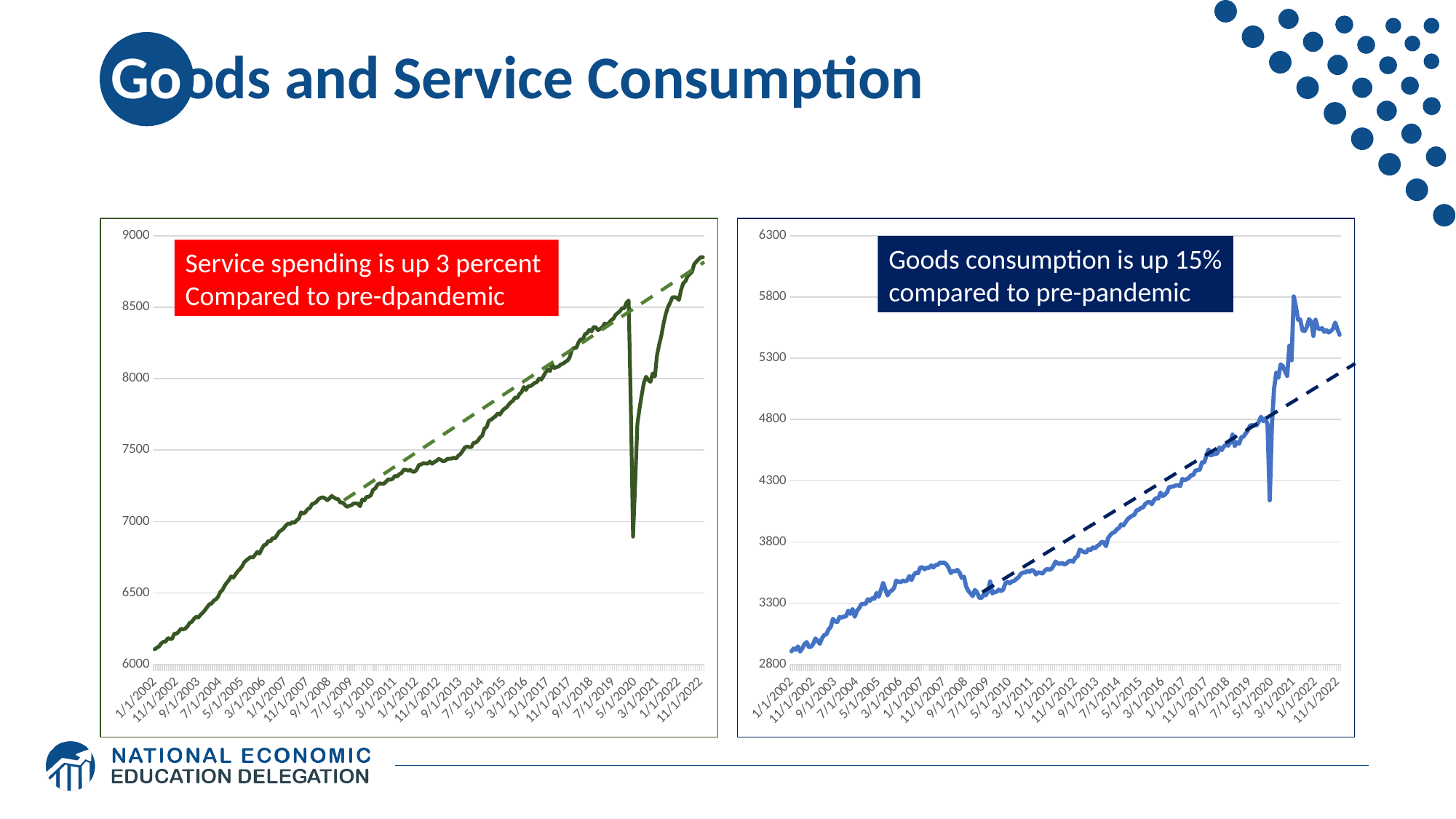
In the right chart (goods consumption), is the value at the end of the series (11/1/2022) greater or less than 5300? greater In the left chart (service spending), do the values generally rise or fall from 1/1/2002 to 11/1/2022? Rise In the left chart (service spending), is the value at 1/1/2002 greater or less than 6500? less According to the text box on the left chart, by how much is service spending up compared to pre-pandemic? 3 percent What kind of chart is the left chart on the slide? Line chart In the right chart (goods consumption), is the lowest point of the 2020 dip greater or less than 4300? less What kind of chart is the right chart on the slide? Line chart According to the text box on the right chart, by how much is goods consumption up compared to pre-pandemic? 15% In the right chart (goods consumption), do the values generally rise or fall from 1/1/2002 to 11/1/2022? Rise